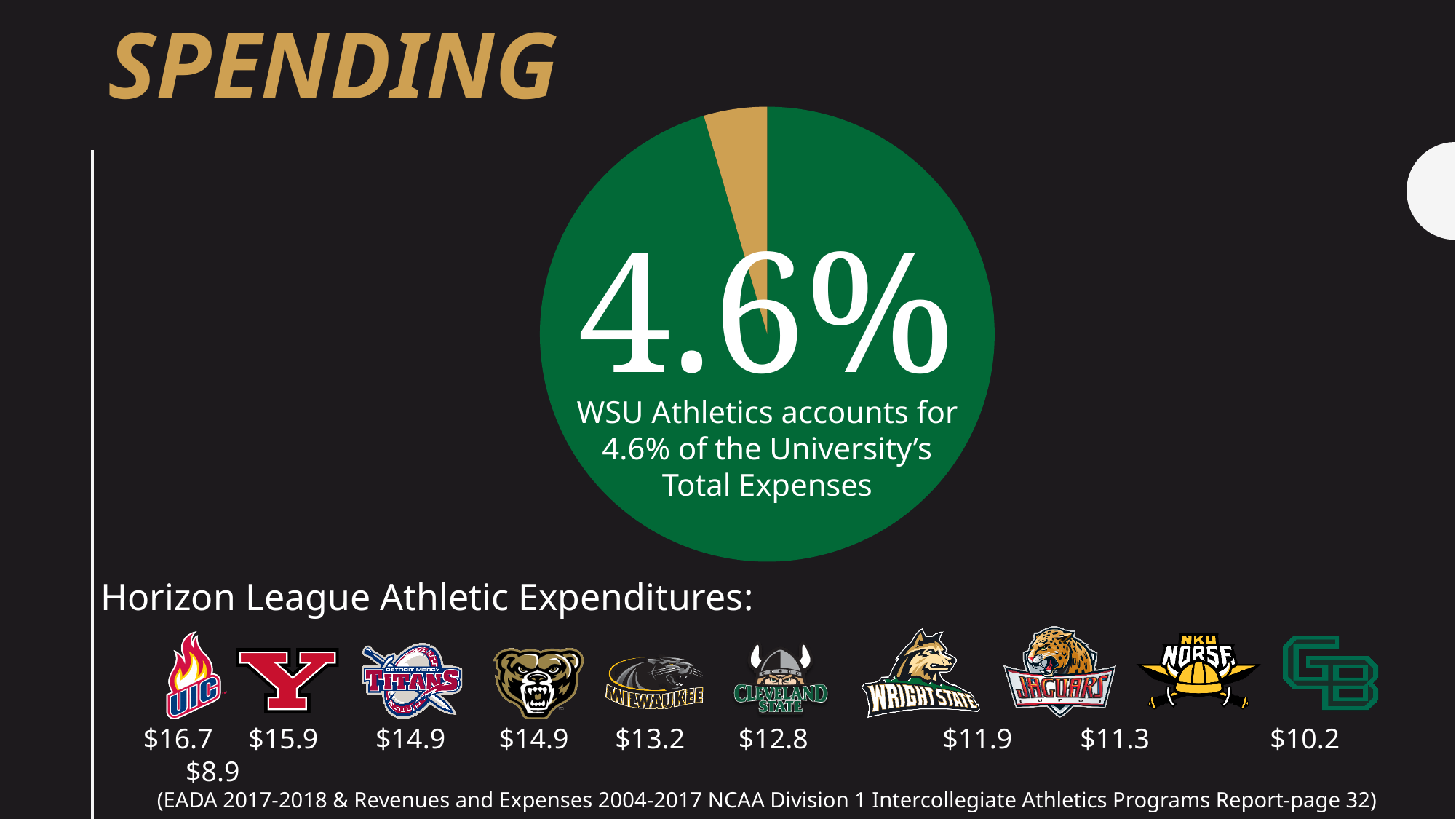
How many slices does the pie chart have? 2 What colour is the slice representing WSU Athletics in the pie chart? gold What is the title of the slide containing the pie chart? SPENDING In the Horizon League Athletic Expenditures row, what is the figure shown under the Cleveland State logo? $12.8 What share of the University's total expenses does WSU Athletics account for, according to the pie chart? 4.6% Which slice of the pie chart is larger, the green slice or the gold slice? the green slice Is the WSU Athletics share shown in the pie chart greater or less than 10%? less In the Horizon League Athletic Expenditures row, what is the figure shown under the Wright State logo? $11.9 What percentage is printed in the centre of the pie chart? 4.6% In the Horizon League Athletic Expenditures row, what is the difference between the Milwaukee figure and the Cleveland State figure? $0.4 In the Horizon League Athletic Expenditures row, what is the figure shown under the Milwaukee logo? $13.2 What kind of chart is shown on the slide? pie chart